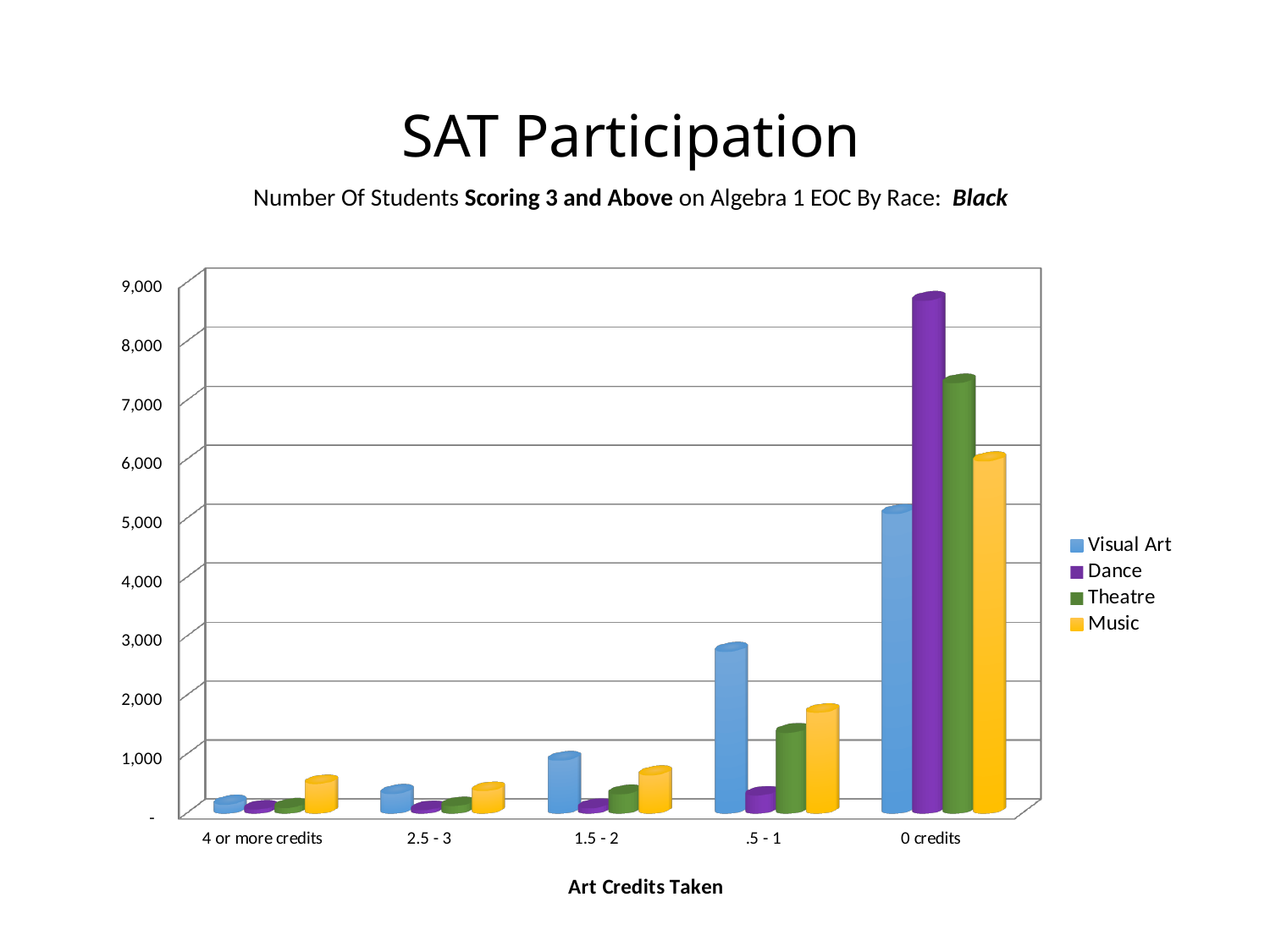
Do the Visual Art values rise or fall moving along the x axis from 4 or more credits to 0 credits? rise Is the value for Dance in the 0 credits category greater or less than 8,000? greater Is the value for Visual Art in the .5 - 1 category greater or less than 2,000? greater How many series does the legend list? 4 In the .5 - 1 category, which is larger, Visual Art or Dance? Visual Art How many art-credit categories are shown on the x axis? 5 Which series has the highest value in the 0 credits category? Dance For the Visual Art series, which category has the highest value? 0 credits Is the value for Dance in the .5 - 1 category greater or less than 1,000? less What is the title of the x axis? Art Credits Taken What kind of chart is shown on the slide? bar chart